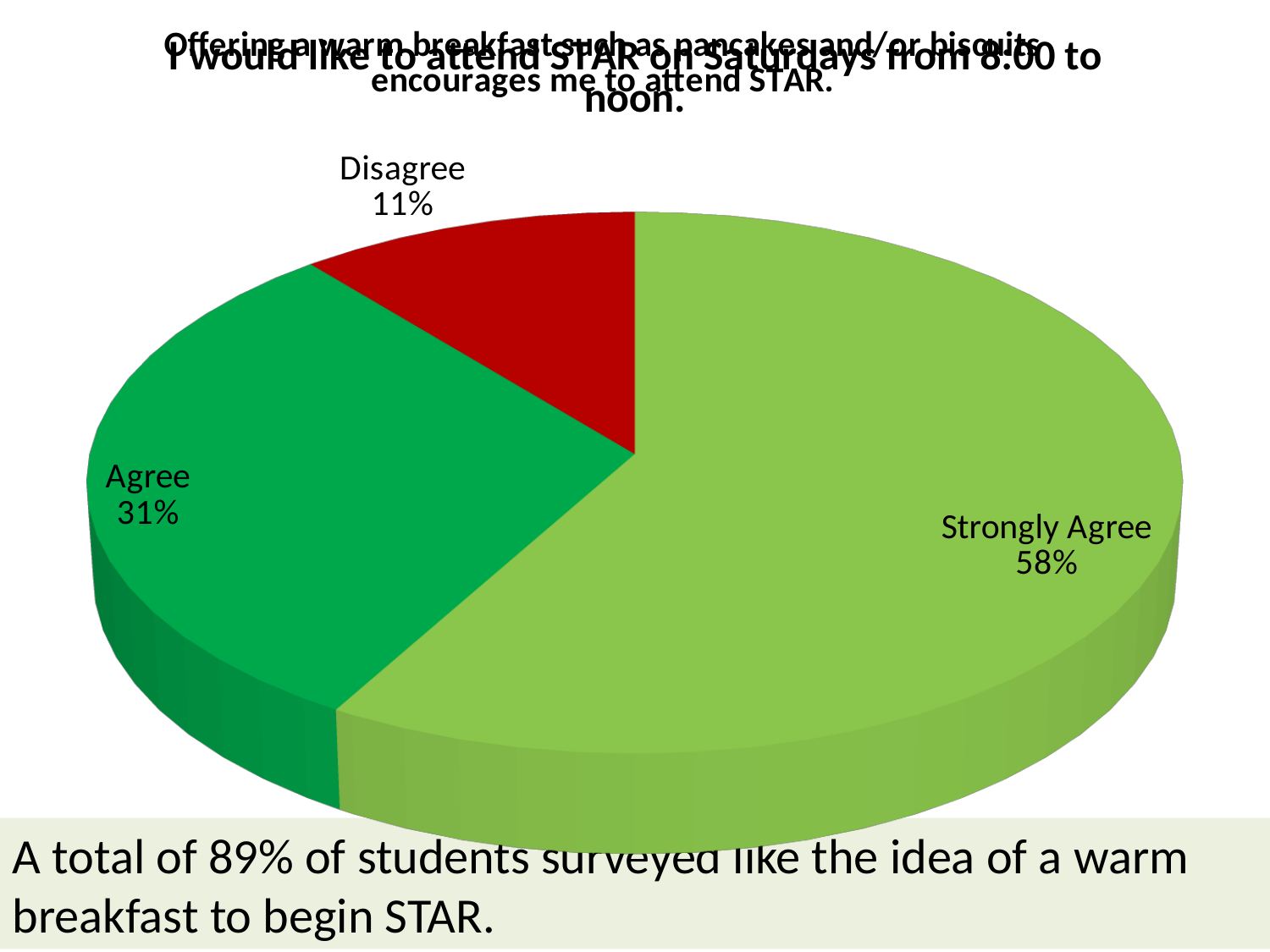
What kind of chart is shown on the slide? pie chart What percentage of the pie is labelled Agree? 31% Which slice of the pie chart is the smallest? Disagree Which is larger, the Agree slice or the Disagree slice? Agree What percentage of the pie is labelled Disagree? 11% What colour is the Disagree slice of the pie chart? red What is the difference in percentage points between the Agree and Disagree slices? 20 What is the difference in percentage points between the Strongly Agree and Agree slices? 27 Which slice of the pie chart is the largest? Strongly Agree What is the combined share of the Strongly Agree and Agree slices? 89% How many slices does the pie chart have? 3 What percentage of the pie is labelled Strongly Agree? 58%